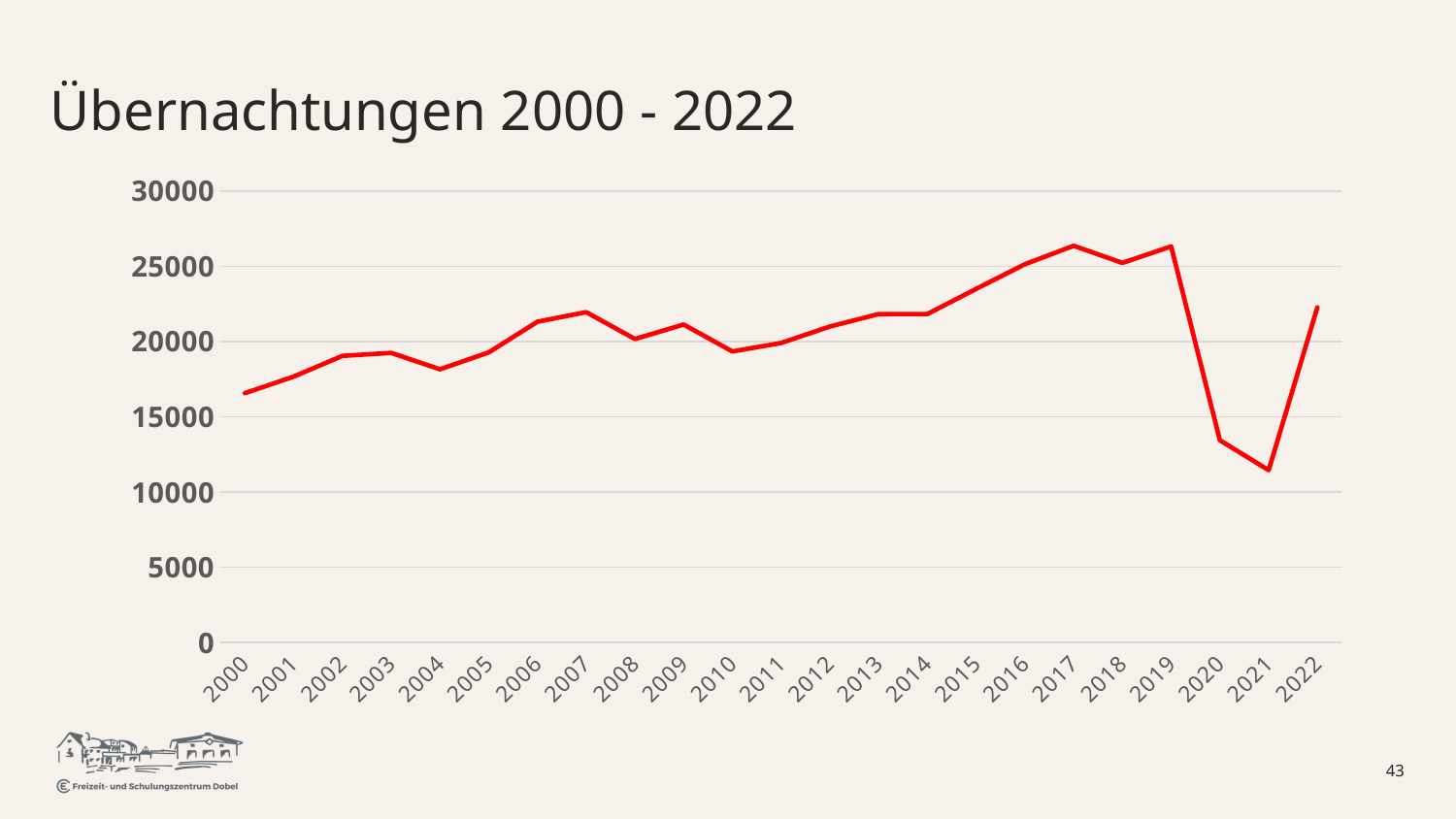
Is the value for 2010 greater or less than 20000? less Is the value for 2007 greater or less than 20000? greater Which year has the larger value, 2019 or 2020? 2019 Is the value for 2021 greater or less than 15000? less What is the title of the chart? Übernachtungen 2000 - 2022 Which year has the lowest value? 2021 Which year has the larger value, 2000 or 2016? 2016 Do the values rise or fall from 2019 to 2021? fall How many years are plotted on the x axis? 23 What kind of chart is shown on the slide? line chart